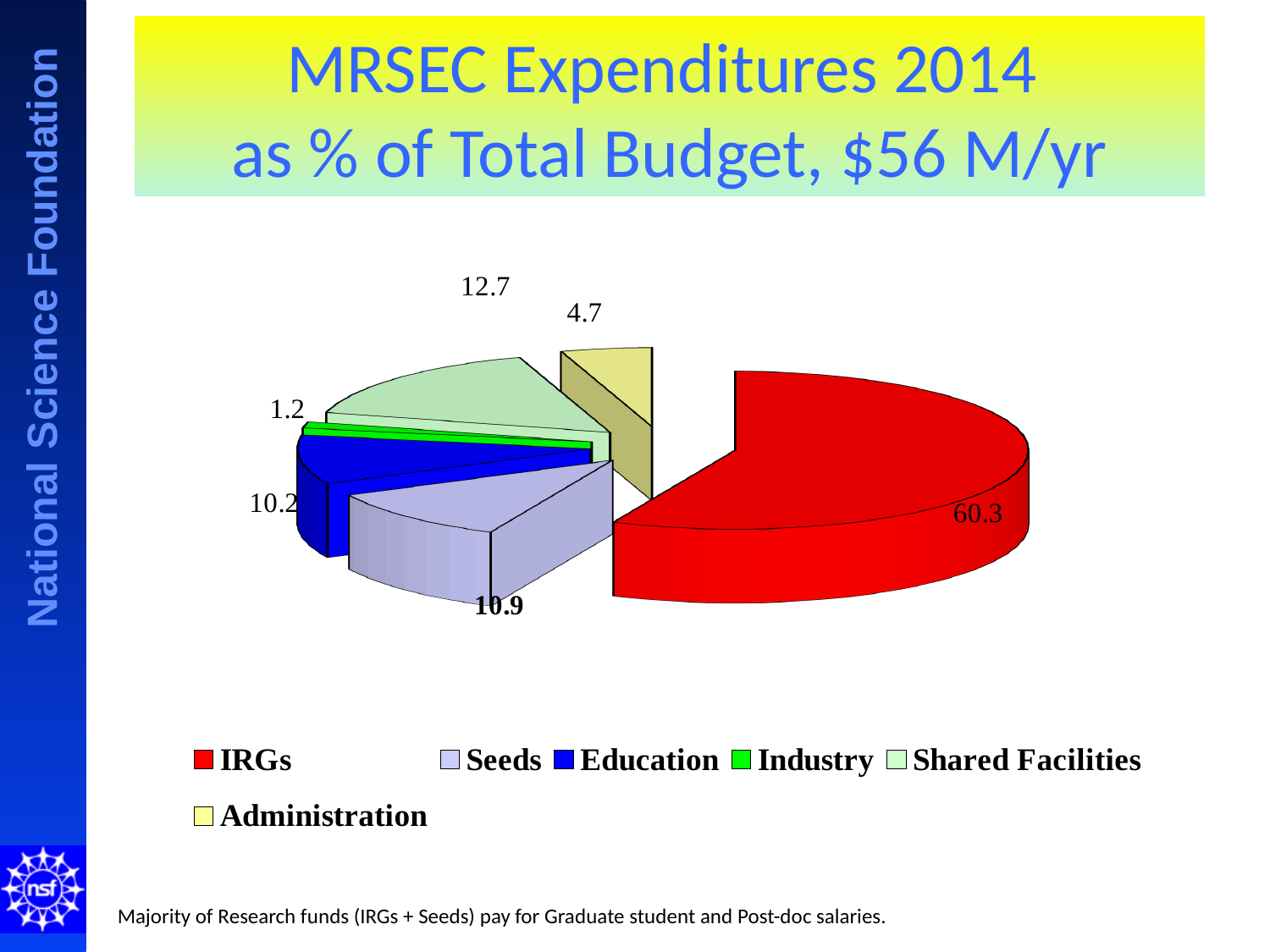
What is the difference between the values for IRGs and Shared Facilities? 47.6 How many categories does the legend list? 6 Which colour represents Industry in the pie chart? Green What is the value shown for Shared Facilities? 12.7 Which category has the largest slice of the pie? IRGs What is the value shown for IRGs? 60.3 What kind of chart is shown on the slide? Pie chart What is the value shown for Seeds? 10.9 What is the value shown for Administration? 4.7 What is the title of the chart on the slide? MRSEC Expenditures 2014 as % of Total Budget, $56 M/yr Which is larger, the value for Education or the value for Administration? Education Which category has the smallest slice of the pie? Industry